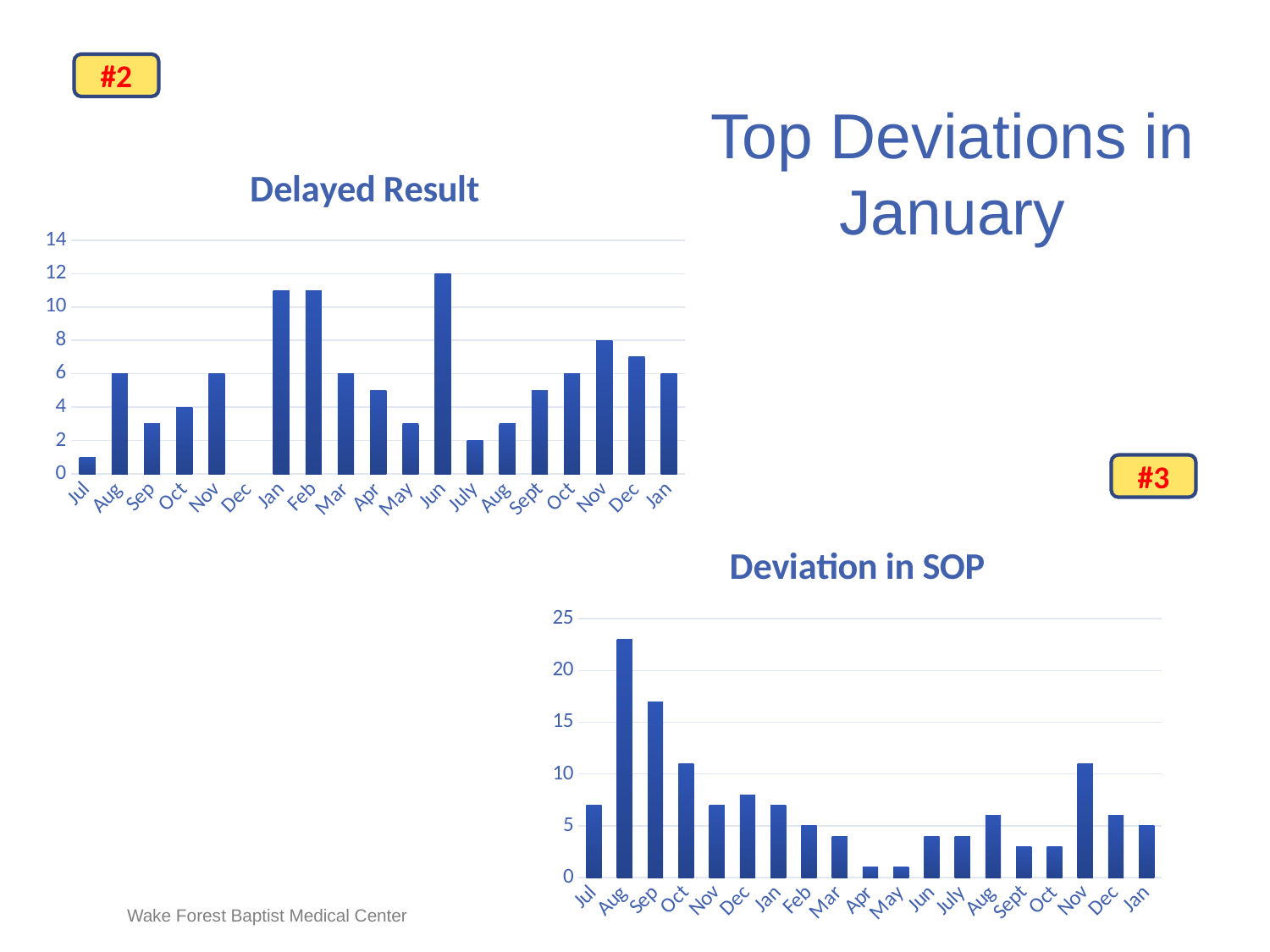
How many bars (months) are plotted in the "Delayed Result" chart? 18 In the "Deviation in SOP" chart, is the value for Sep greater or less than 15? greater In the "Delayed Result" chart, which month has the highest value? Jun In the "Delayed Result" chart, which is larger, the value for Jun or the value for Mar? Jun In the "Delayed Result" chart, is the value for Feb greater or less than 10? greater In the "Deviation in SOP" chart, do the values rise or fall from Aug to Mar? fall What type of chart is the "Delayed Result" chart? bar chart In the "Delayed Result" chart, what is the value for Jun? 12 In the "Deviation in SOP" chart, which month label has the tallest bar? Aug In the "Delayed Result" chart, what is the value for Mar? 6 In the "Delayed Result" chart, is the value for Sep greater or less than 4? less In the "Deviation in SOP" chart, what is the value for Feb? 5